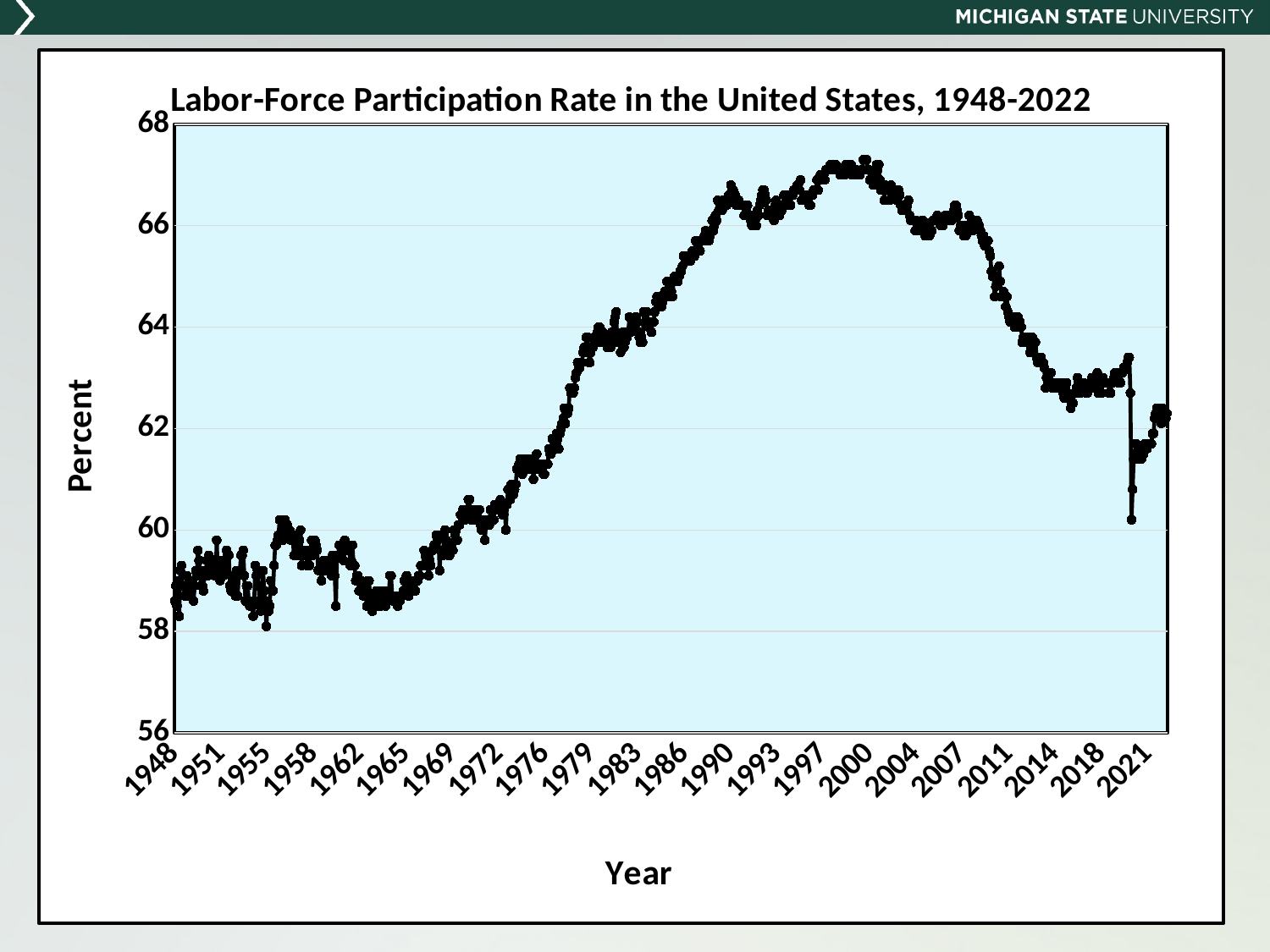
Is the labor-force participation rate in 2000 greater or less than 66? greater Is the labor-force participation rate in 1948 greater or less than 60? less Does the labor-force participation rate rise or fall between 1965 and 2000? rise Around which year on the x axis does the labor-force participation rate reach its highest level? 2000 What is the label on the vertical axis of the chart? Percent What kind of chart is shown on the slide? line chart Does the labor-force participation rate rise or fall between 2000 and 2014? fall Which is larger, the labor-force participation rate in 1990 or in 2021? 1990 What is the title of the chart? Labor-Force Participation Rate in the United States, 1948-2022 Is the labor-force participation rate in 2014 greater or less than 64? less